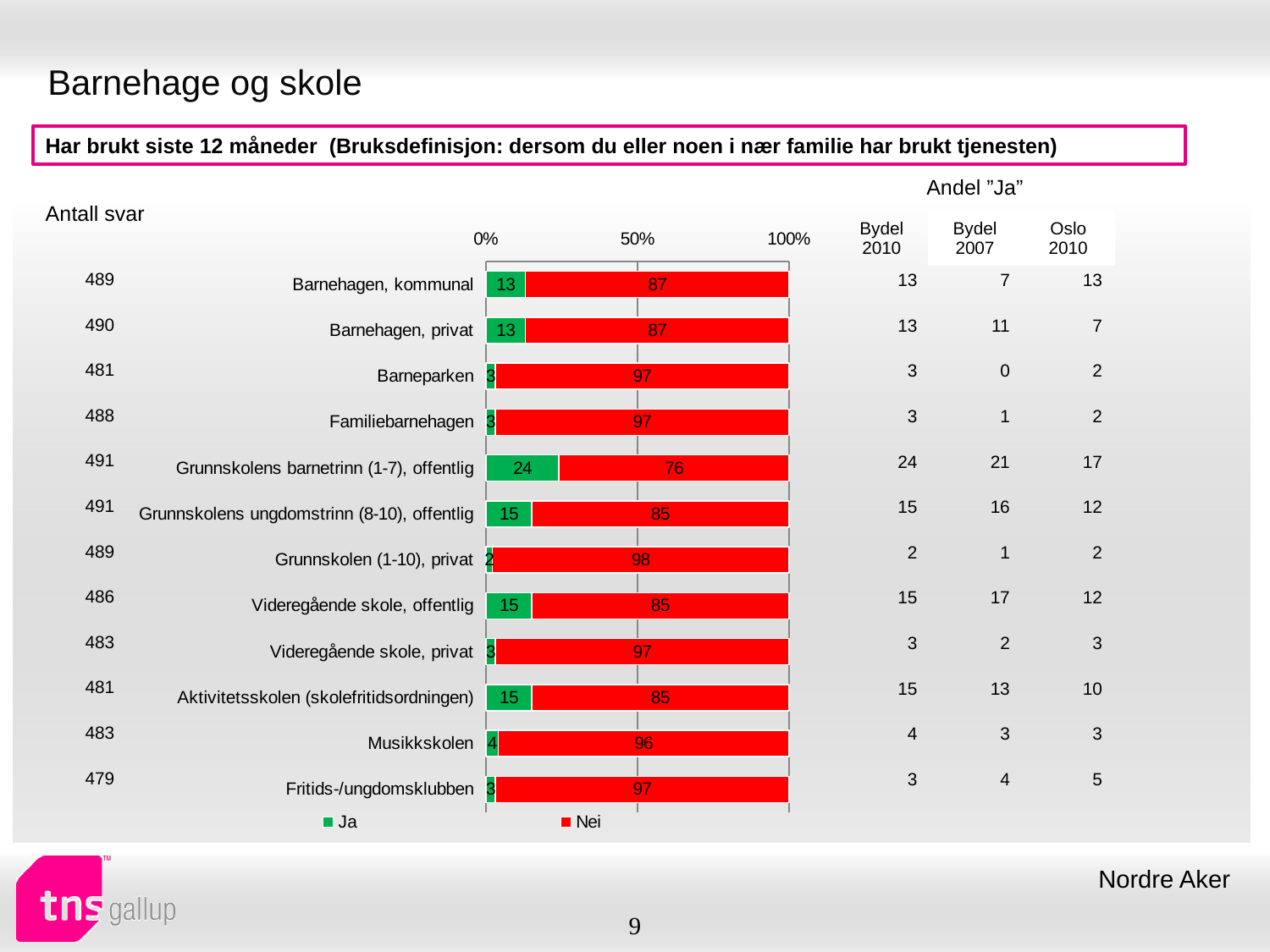
How many series does the legend list? 2 What is the "Ja" value for Musikkskolen? 4 What is the difference between the "Ja" values for Grunnskolens barnetrinn (1-7), offentlig and Videregående skole, offentlig? 9 Which category has the lowest "Ja" value? Grunnskolen (1-10), privat Which has a larger "Ja" value, Barnehagen, kommunal or Musikkskolen? Barnehagen, kommunal What kind of chart is shown on the slide? Stacked bar chart Is the "Nei" value for Aktivitetsskolen (skolefritidsordningen) greater or less than 50%? greater Which category has the highest "Ja" value? Grunnskolens barnetrinn (1-7), offentlig What is the "Nei" value for Barnehagen, kommunal? 87 How many categories are shown in the bar chart? 12 What is the "Nei" value for Grunnskolen (1-10), privat? 98 What is the "Ja" value for Grunnskolens barnetrinn (1-7), offentlig? 24